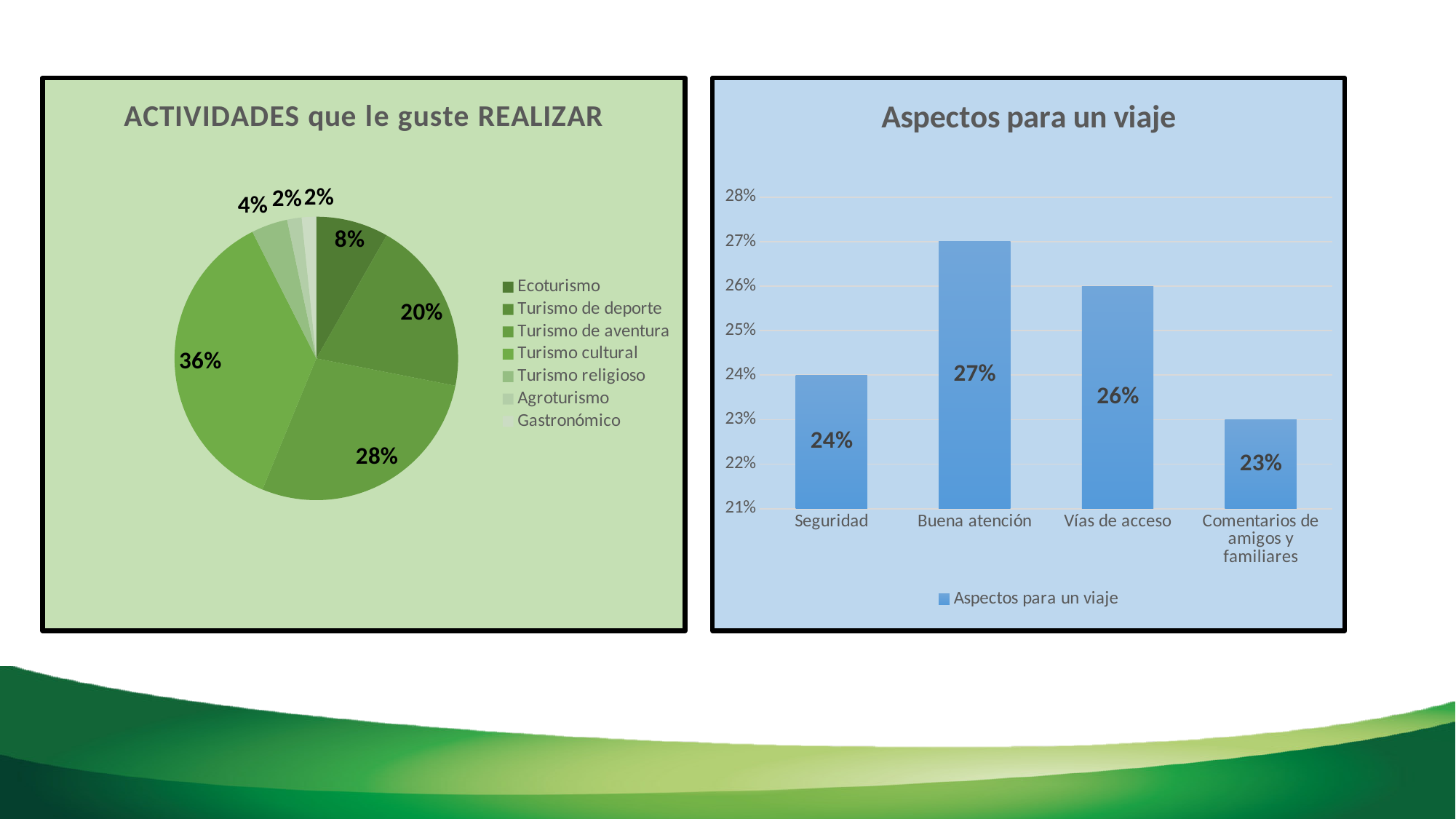
How many categories does the legend of the 'ACTIVIDADES que le guste REALIZAR' chart list? 7 In the 'ACTIVIDADES que le guste REALIZAR' chart, which category has the largest slice? Turismo cultural What kind of chart is 'Aspectos para un viaje'? Bar chart In the 'Aspectos para un viaje' chart, what is the value for Buena atención? 27% In the 'Aspectos para un viaje' chart, which category has the highest value? Buena atención In the 'Aspectos para un viaje' chart, what is the difference between Buena atención and Seguridad? 3% In the 'Aspectos para un viaje' chart, what is the value for Comentarios de amigos y familiares? 23% In the 'Aspectos para un viaje' chart, which is larger, Vías de acceso or Seguridad? Vías de acceso In the 'ACTIVIDADES que le guste REALIZAR' chart, what share does Turismo cultural have? 36% In the 'ACTIVIDADES que le guste REALIZAR' chart, what share does Ecoturismo have? 8% In the 'Aspectos para un viaje' chart, how many categories are shown? 4 In the 'Aspectos para un viaje' chart, which category has the lowest value? Comentarios de amigos y familiares